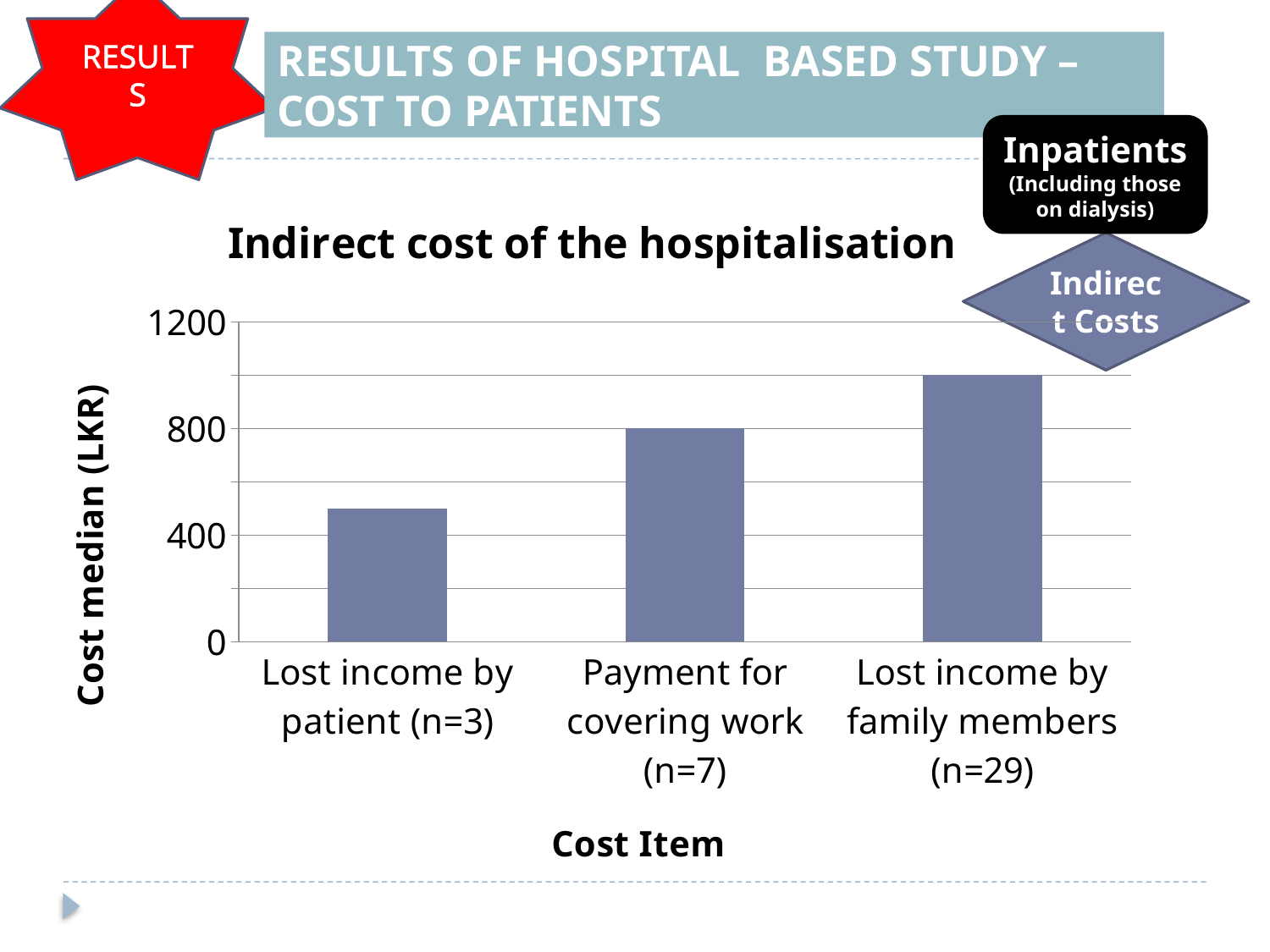
How many cost items are plotted in the chart? 3 What is the label on the vertical axis of the chart? Cost median (LKR) Which cost item has the highest median cost? Lost income by family members (n=29) Is the value for Lost income by patient (n=3) greater or less than 400? greater What kind of chart is shown on the slide? Bar chart Is the value for Lost income by patient (n=3) greater or less than 800? less Which cost item has the lowest median cost? Lost income by patient (n=3) Is the value for Lost income by family members (n=29) greater or less than 800? greater What is the median cost for Payment for covering work (n=7)? 800 What is the title of the chart? Indirect cost of the hospitalisation Do the bar values rise or fall from left to right along the x axis? Rise Which is larger: the median cost for Payment for covering work (n=7) or for Lost income by patient (n=3)? Payment for covering work (n=7)